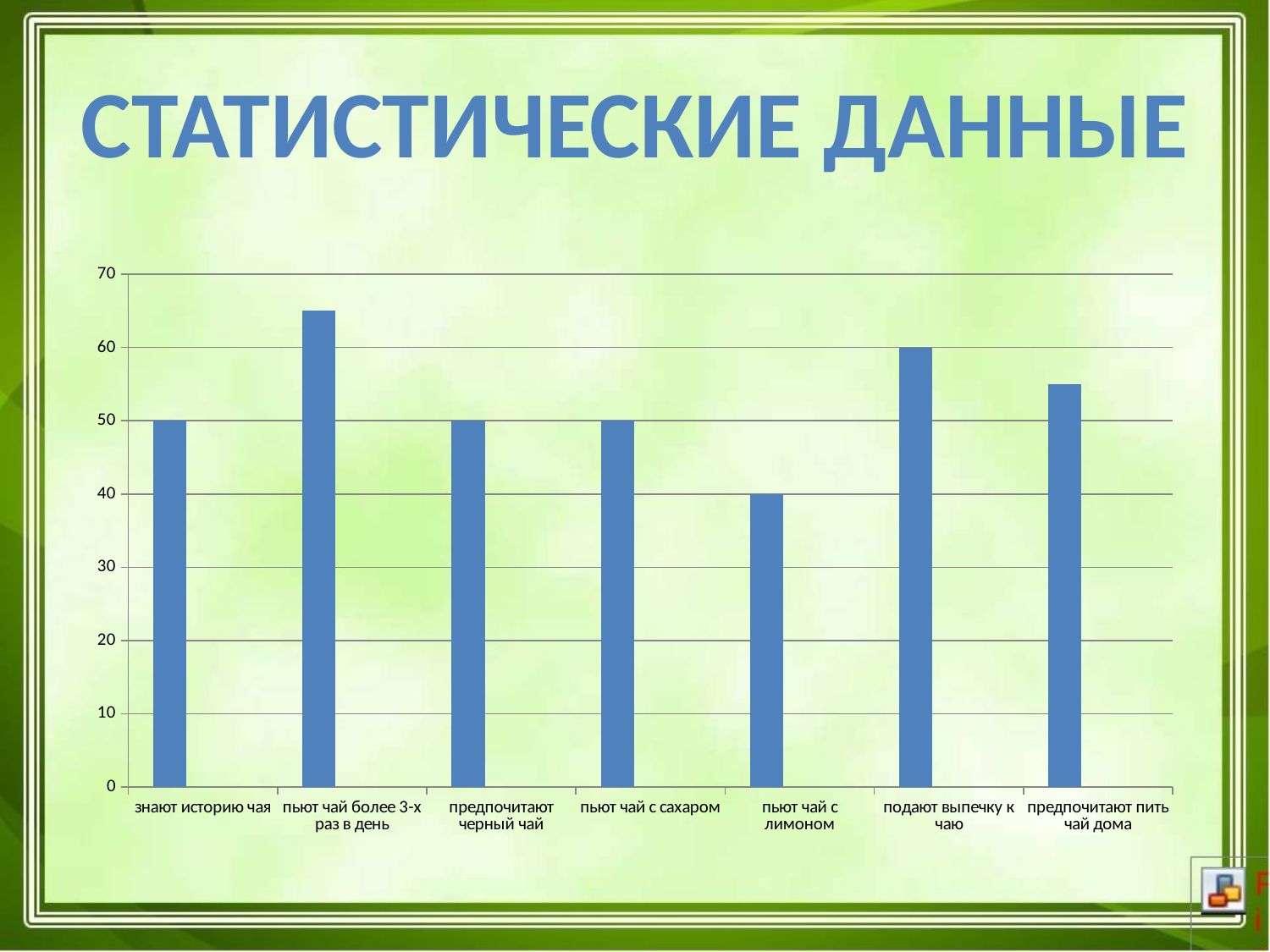
Is the value for "предпочитают пить чай дома" greater or less than 60? less What is the value for "пьют чай с сахаром"? 50 Which category has the highest value? пьют чай более 3-х раз в день Which is larger, the value for "подают выпечку к чаю" or the value for "предпочитают черный чай"? подают выпечку к чаю What type of chart is shown on the slide? bar chart How many categories are shown on the x axis of the chart? 7 What is the value for "знают историю чая"? 50 What is the value for "пьют чай с лимоном"? 40 Is the value for "пьют чай более 3-х раз в день" greater or less than 60? greater Which category has the lowest value? пьют чай с лимоном What is the value for "подают выпечку к чаю"? 60 What is the difference between the values for "подают выпечку к чаю" and "пьют чай с лимоном"? 20